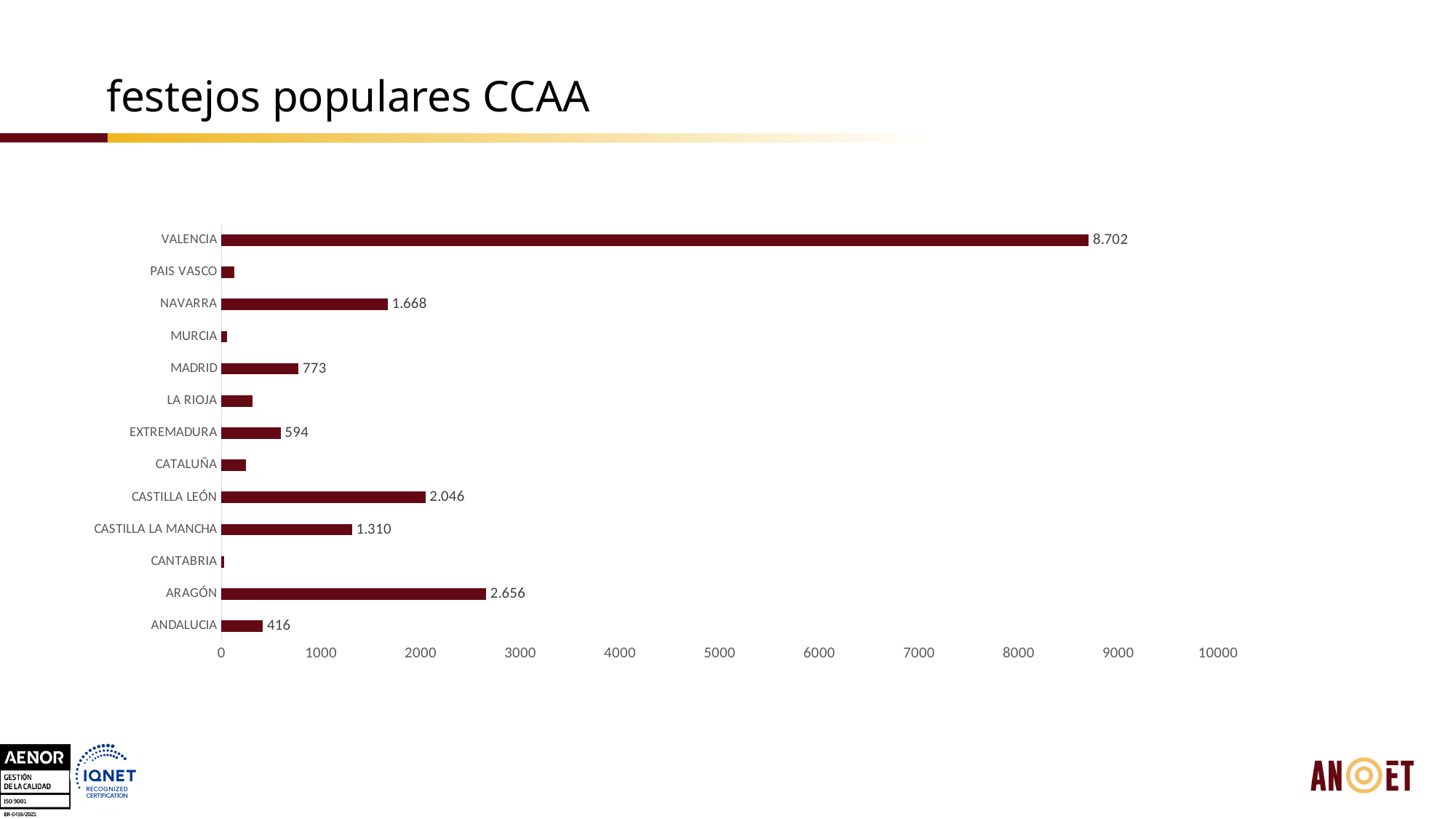
Which region has the highest value? VALENCIA What is the value for CASTILLA LA MANCHA? 1.310 Is the value for LA RIOJA greater or less than 1000? less How many regions are shown on the chart? 13 What is the maximum value shown on the horizontal axis? 10000 Which region has the lowest value? CANTABRIA What is the title of the slide? festejos populares CCAA What is the value for VALENCIA? 8.702 What is the difference between the values for CASTILLA LEÓN and NAVARRA? 378 What is the value for ARAGÓN? 2.656 What kind of chart is shown on the slide? bar chart Which is larger, the value for MADRID or the value for EXTREMADURA? MADRID